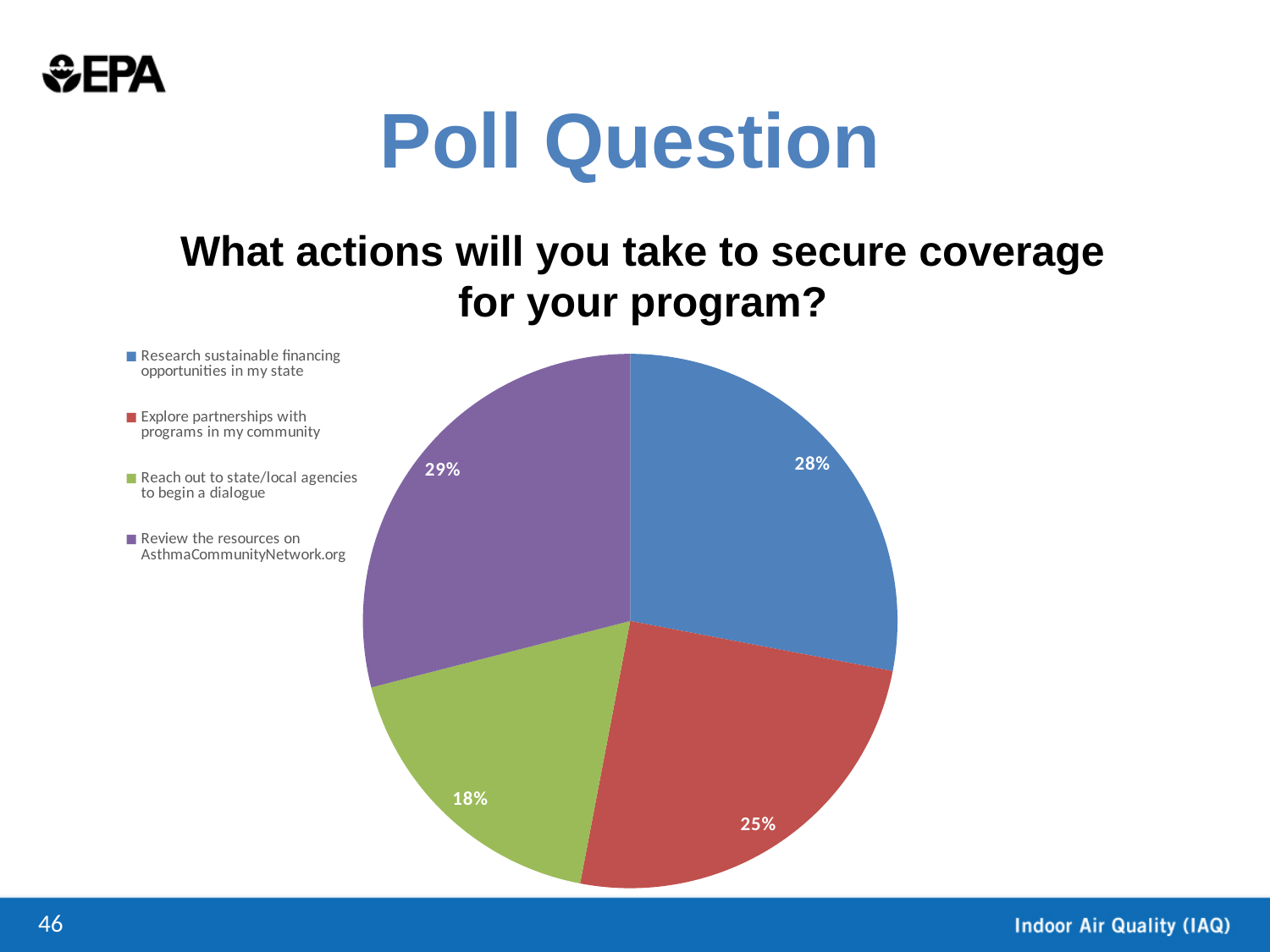
What question does the chart title ask? What actions will you take to secure coverage for your program? What share of the pie is 'Review the resources on AsthmaCommunityNetwork.org'? 29% What share of the pie is 'Reach out to state/local agencies to begin a dialogue'? 18% How many slices does the pie chart have? 4 Which response has the largest share of the pie? Review the resources on AsthmaCommunityNetwork.org Which is larger: the share for 'Research sustainable financing opportunities in my state' or the share for 'Explore partnerships with programs in my community'? Research sustainable financing opportunities in my state What share of the pie is 'Explore partnerships with programs in my community'? 25% What kind of chart is shown on the slide? pie chart Which response has the smallest share of the pie? Reach out to state/local agencies to begin a dialogue What is the difference in percentage points between 'Review the resources on AsthmaCommunityNetwork.org' and 'Reach out to state/local agencies to begin a dialogue'? 11 percentage points What share of the pie is 'Research sustainable financing opportunities in my state'? 28% What colour is the slice for 'Reach out to state/local agencies to begin a dialogue'? green